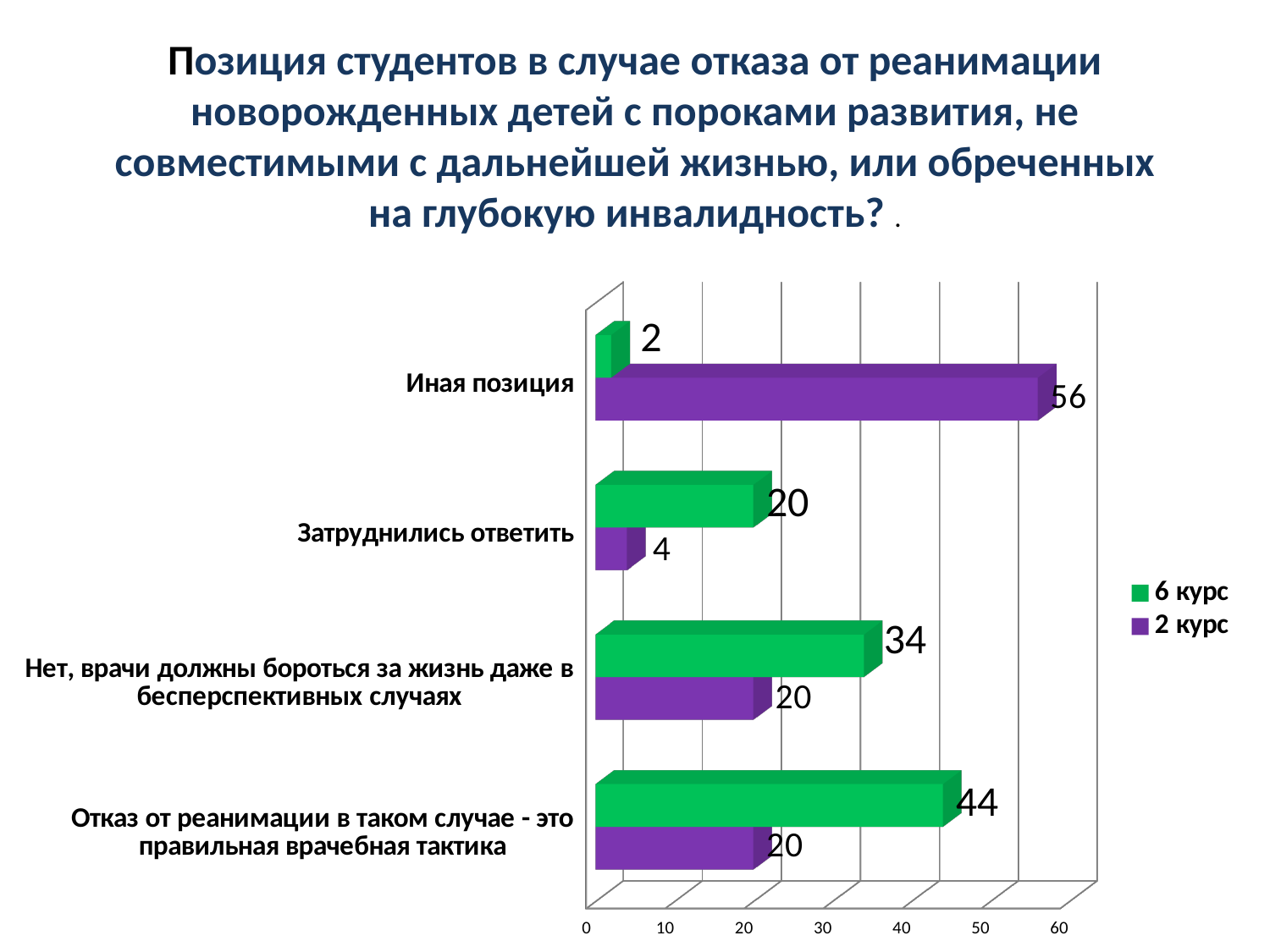
What is the value for "6 курс" in the category "Затруднились ответить"? 20 What is the value for "2 курс" in the category "Нет, врачи должны бороться за жизнь даже в бесперспективных случаях"? 20 What is the value for "6 курс" in the category "Отказ от реанимации в таком случае - это правильная врачебная тактика"? 44 Which category has the highest value for "6 курс"? Отказ от реанимации в таком случае - это правильная врачебная тактика What is the value for "2 курс" in the category "Иная позиция"? 56 What is the difference between the "2 курс" and "6 курс" values in the category "Иная позиция"? 54 Which colour represents the "2 курс" series in the legend? purple What kind of chart is shown on the slide? bar chart How many series does the legend list? 2 Which category has the lowest value for "2 курс"? Затруднились ответить In the category "Нет, врачи должны бороться за жизнь даже в бесперспективных случаях", which series has the larger value, "6 курс" or "2 курс"? 6 курс How many categories are shown on the chart? 4